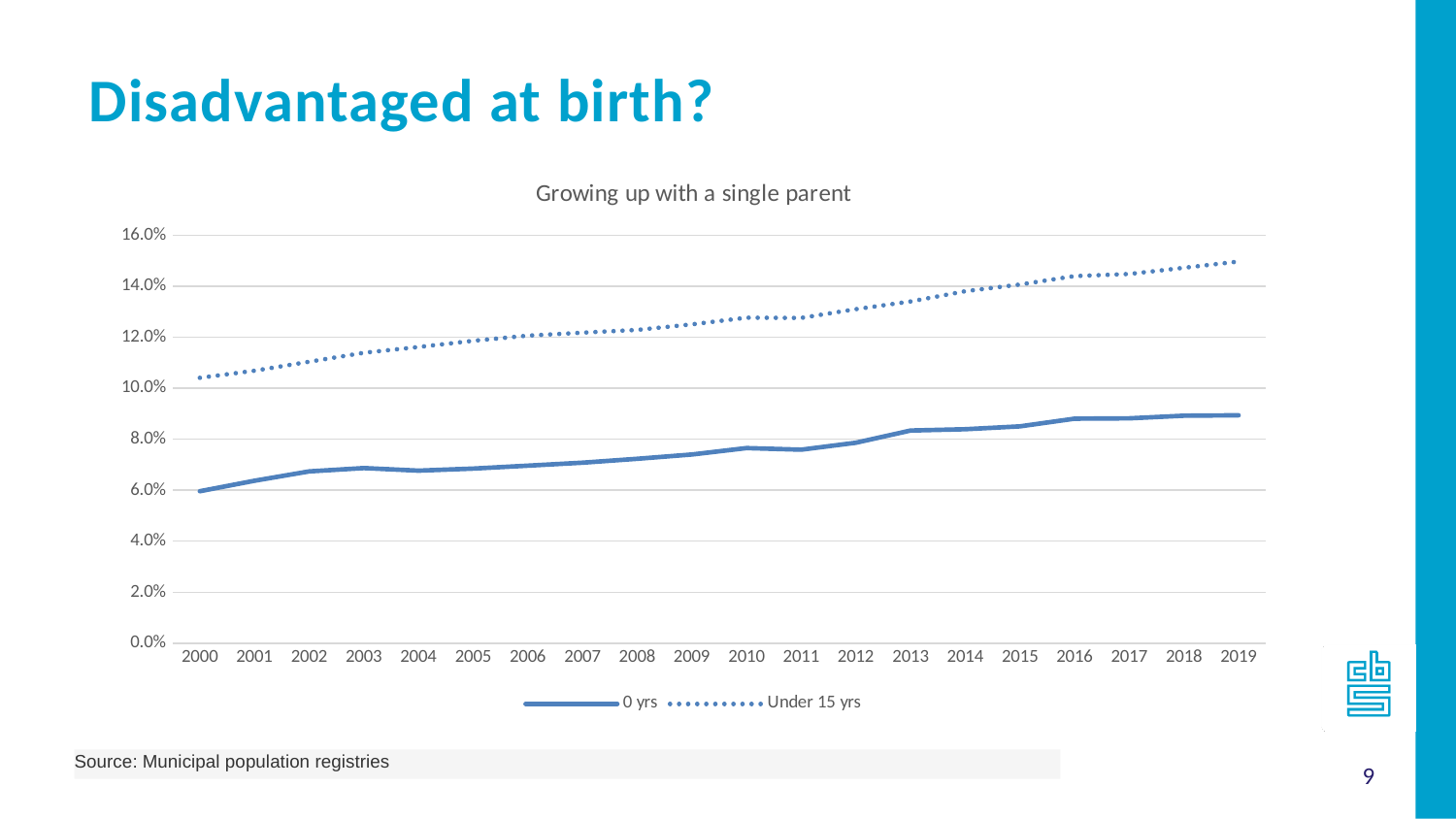
How many years are shown on the x axis? 20 What kind of chart is shown on the slide? Line chart Do the values for the Under 15 yrs series rise or fall from 2000 to 2019? Rise What is the title of the chart? Growing up with a single parent Which series has the higher value in 2019, 0 yrs or Under 15 yrs? Under 15 yrs Is the value for 0 yrs in 2005 greater or less than 6.0%? greater Which series is drawn with a dotted line? Under 15 yrs Is the value for Under 15 yrs in 2019 greater or less than 14.0%? greater Is the value for 0 yrs in 2019 greater or less than 8.0%? greater How many series does the legend list? 2